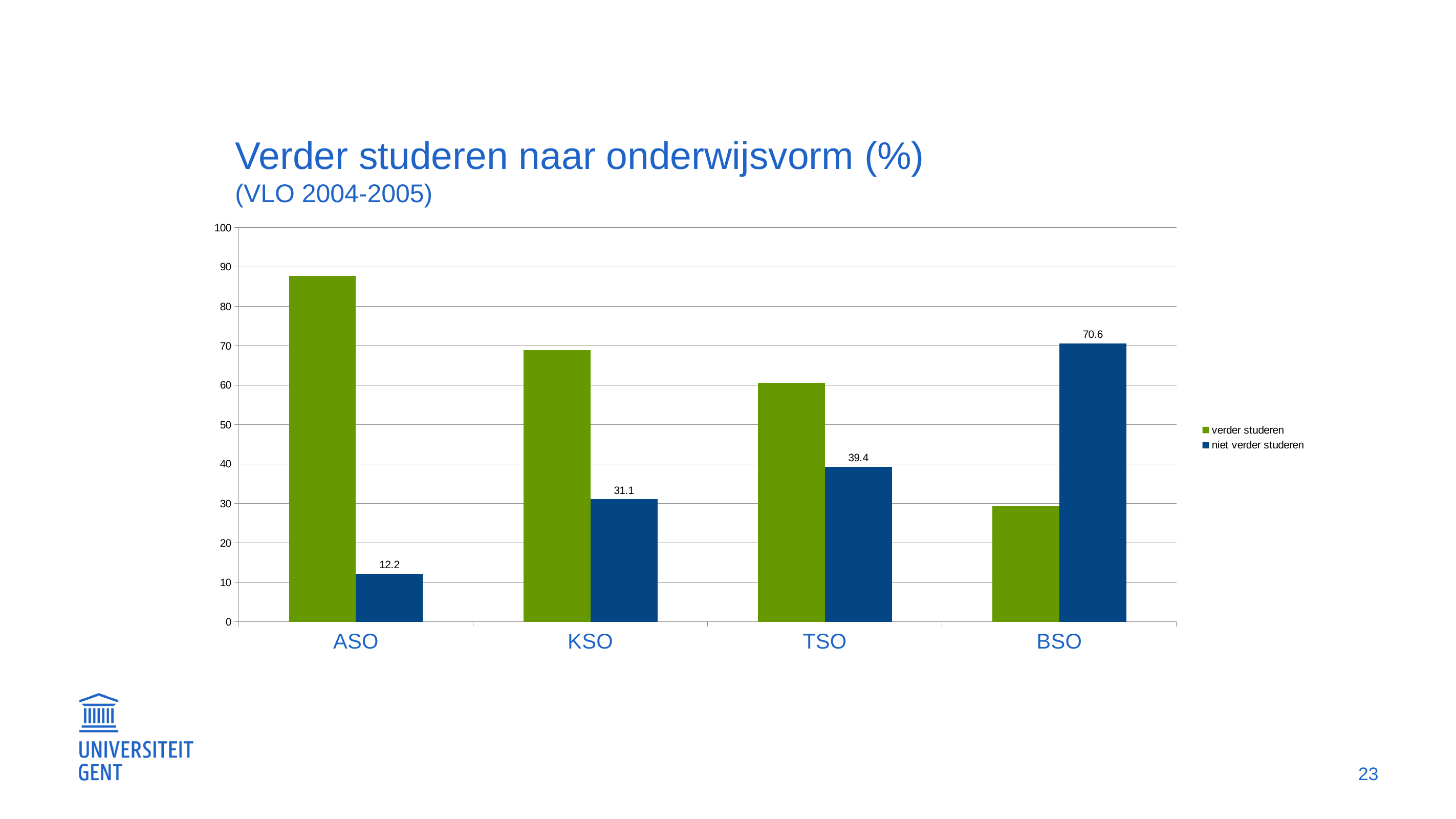
What kind of chart is shown on the slide? bar chart What is the difference between the 'niet verder studeren' values for BSO and ASO? 58.4 What is the value for 'niet verder studeren' for ASO? 12.2 How many series does the legend list? 2 Is the value for 'verder studeren' for ASO greater or less than 80? greater What is the value for 'niet verder studeren' for TSO? 39.4 What is the value for 'niet verder studeren' for KSO? 31.1 What is the value for 'niet verder studeren' for BSO? 70.6 Which category has the lowest value for 'niet verder studeren'? ASO Which category has the highest value for 'niet verder studeren'? BSO Which category has the highest value for 'verder studeren'? ASO